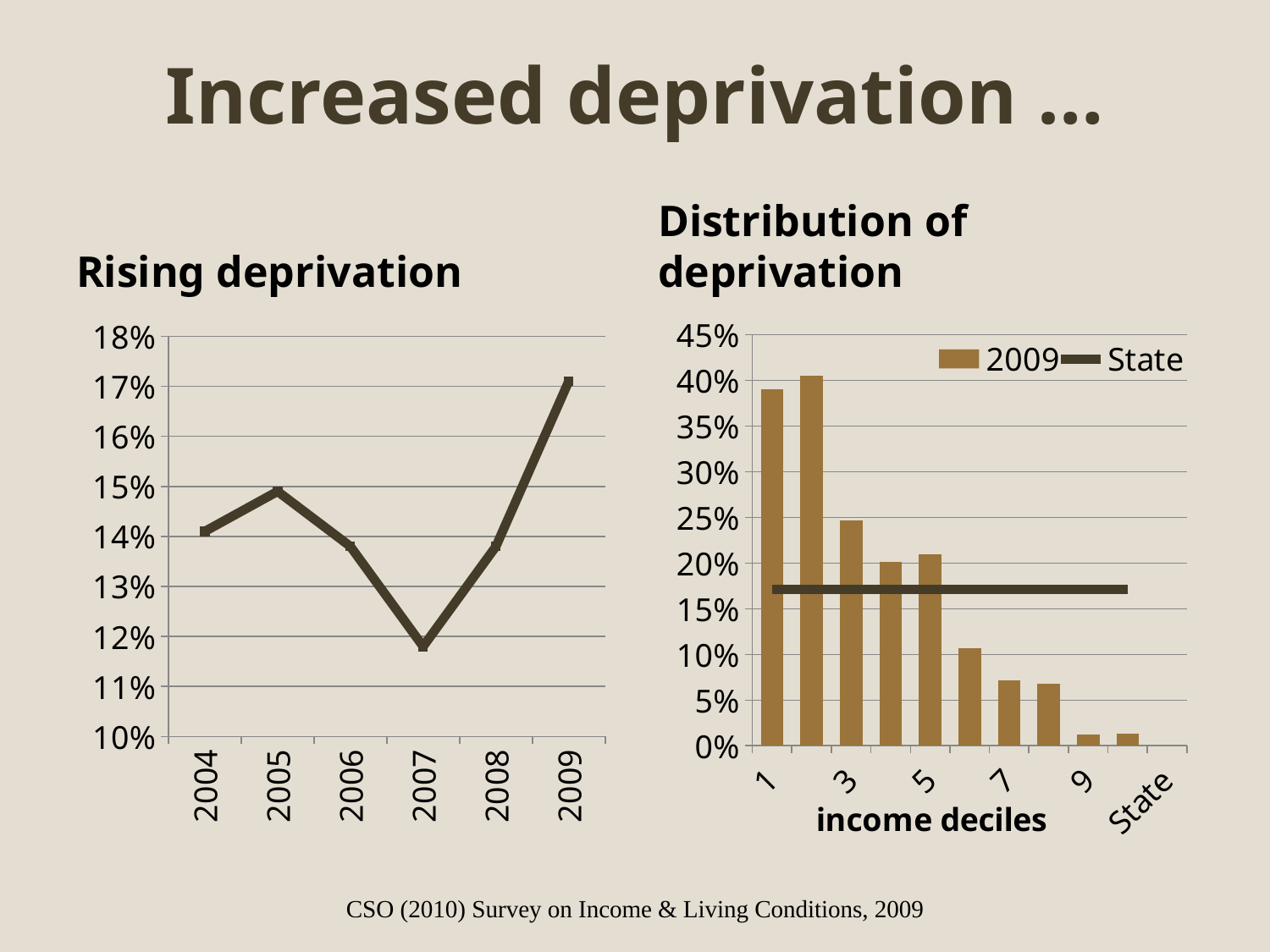
In the 'Distribution of deprivation' chart, is the value for income decile 7 greater or less than 5%? greater In the 'Rising deprivation' chart, which year has the lowest deprivation rate? 2007 What kind of chart is the 'Rising deprivation' chart? line chart In the 'Distribution of deprivation' chart, is the value for income decile 1 greater or less than 35%? greater In the 'Rising deprivation' chart, which year has the highest deprivation rate? 2009 In the 'Distribution of deprivation' chart, which is larger, the bar for income decile 3 or the bar for income decile 6? income decile 3 In the 'Rising deprivation' chart, is the value for 2009 greater or less than 16%? greater How many series does the legend of the 'Distribution of deprivation' chart list? 2 What kind of chart is the 'Distribution of deprivation' chart? combination bar and line chart In the 'Distribution of deprivation' chart, which income decile has the tallest bar? 2 How many years are plotted in the 'Rising deprivation' chart? 6